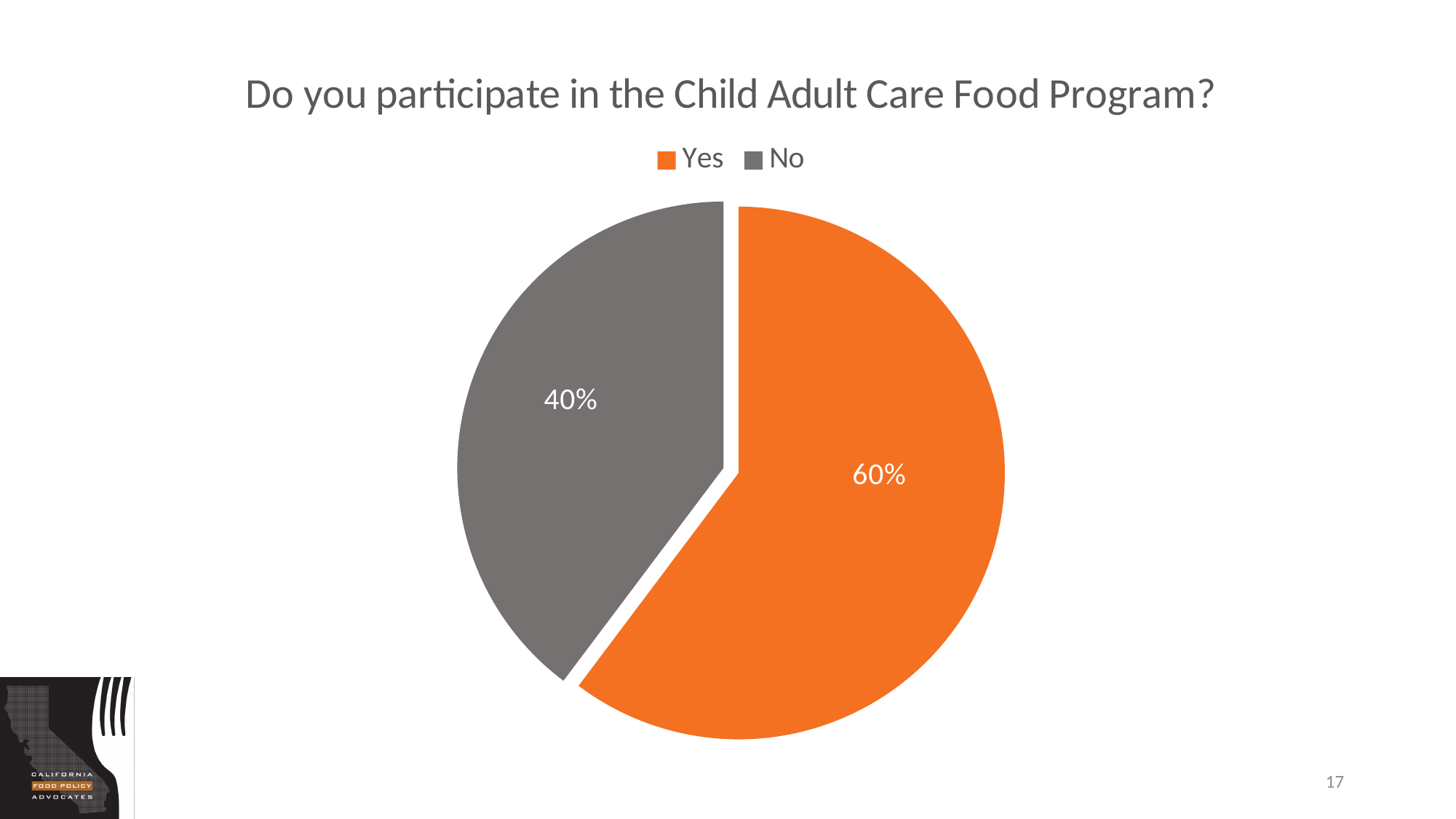
What percentage of respondents answered Yes? 60% How many slices does the pie chart have? 2 What is the difference in percentage points between the Yes and No slices? 20% What kind of chart is shown on the slide? pie chart Which response has the largest share of the pie? Yes Which response has the smallest share of the pie? No What share of the pie does the No slice represent? 40% What percentage of respondents answered No? 40% What colour is the Yes slice? orange Which is larger, the Yes slice or the No slice? Yes What is the title of the chart? Do you participate in the Child Adult Care Food Program? How many entries does the legend list? 2